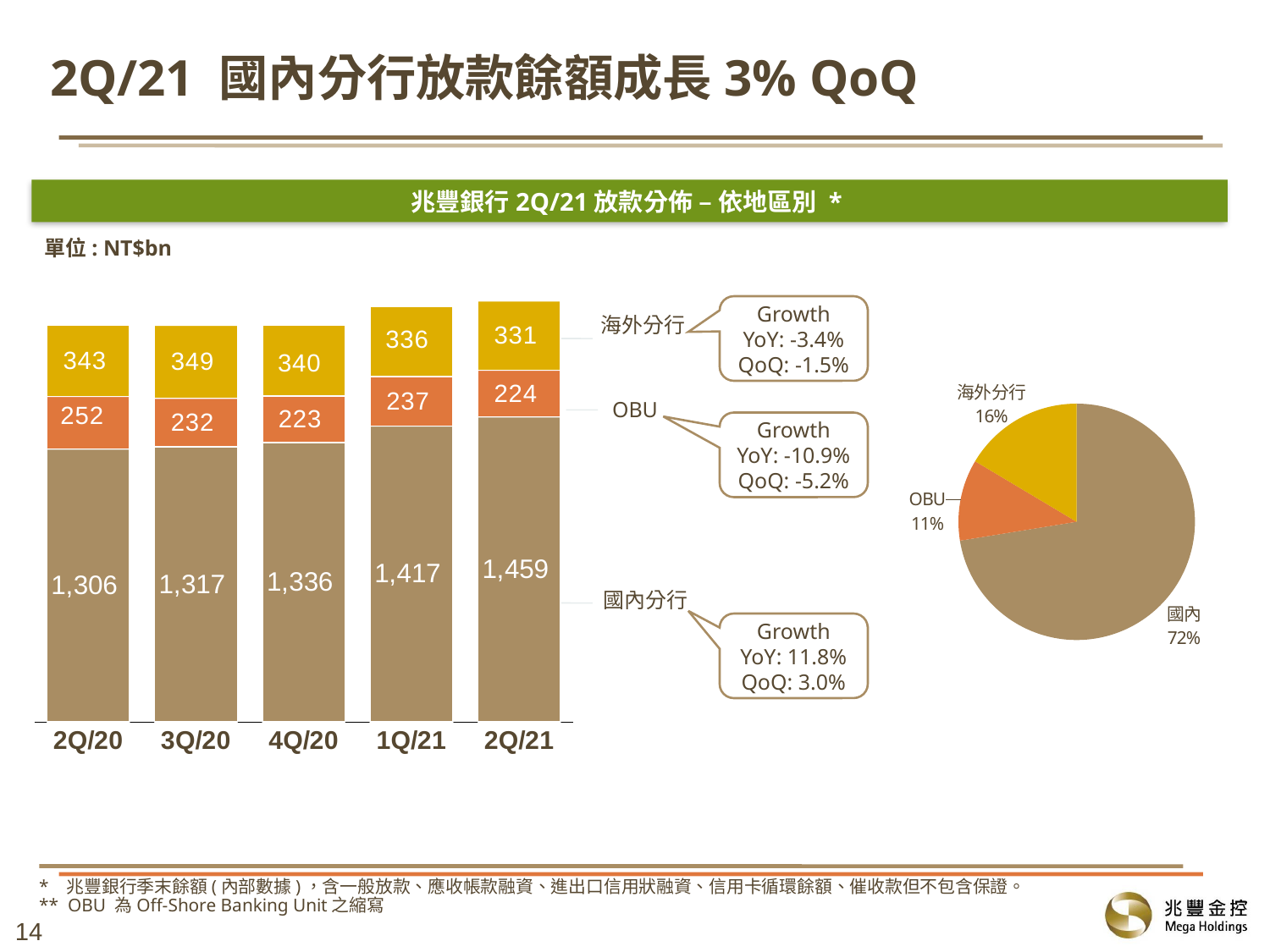
In the stacked bar chart, what is the 海外分行 value in 1Q/21? 336 In the stacked bar chart, which quarter has the lowest OBU value? 4Q/20 In the stacked bar chart, does the 國內分行 value rise or fall from 2Q/20 to 2Q/21? rise In the stacked bar chart, which is larger: 海外分行 in 2Q/20 or in 3Q/20? 3Q/20 In the pie chart, what share does 國內 have? 72% In the pie chart, which segment is the smallest? OBU In the stacked bar chart, what is the OBU value in 3Q/20? 232 In the stacked bar chart, by how much did 國內分行 increase from 1Q/21 to 2Q/21? 42 In the stacked bar chart, what is the value for 國內分行 in 2Q/21? 1,459 In the stacked bar chart, which quarter has the highest 國內分行 value? 2Q/21 In the stacked bar chart, what is the total of the 2Q/21 bar? 2,014 How many quarters are shown in the stacked bar chart? 5